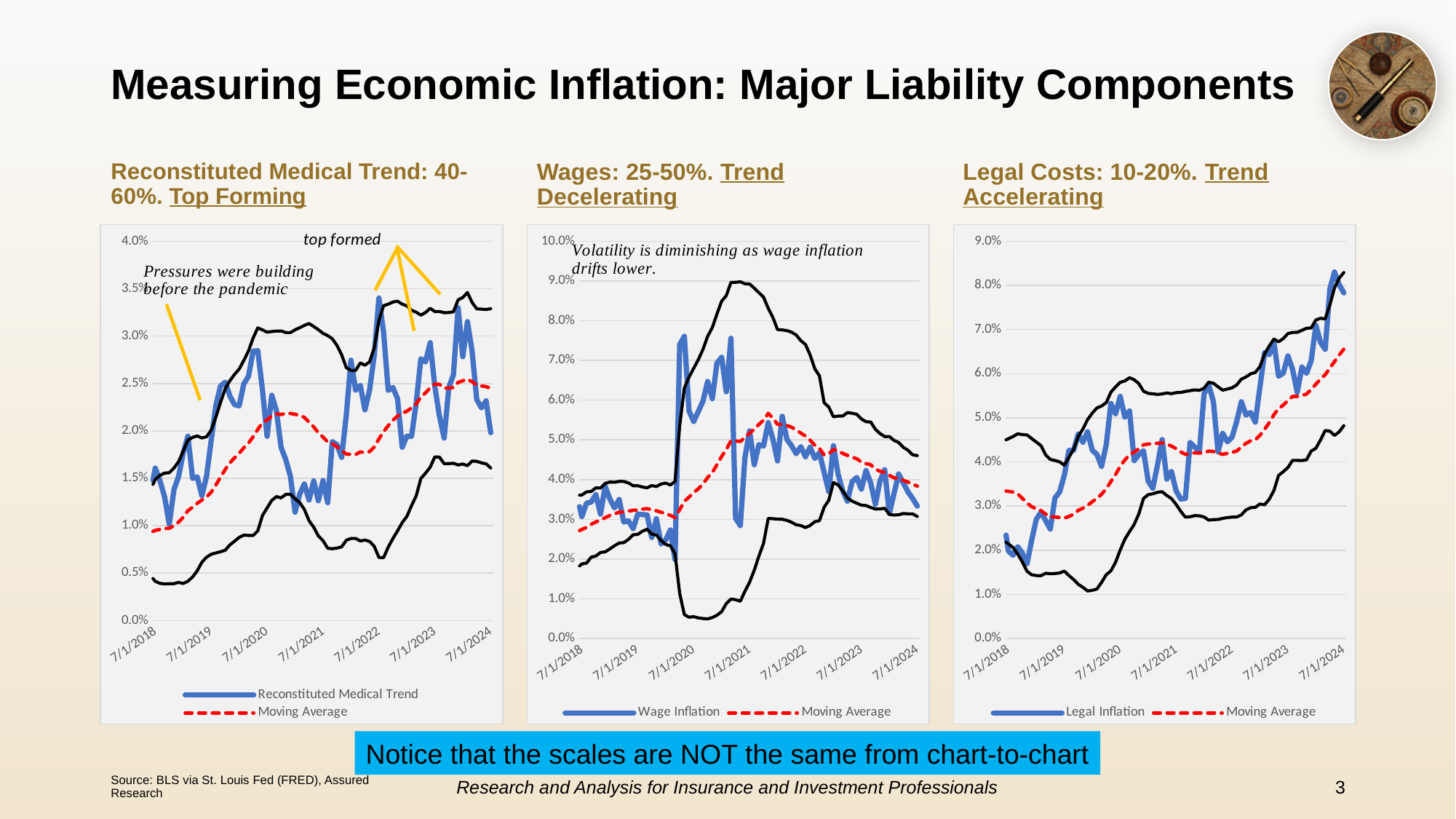
In the right chart, does Legal Inflation generally rise or fall from 7/1/2018 to 7/1/2024? Rise In the left chart, is the peak of the Reconstituted Medical Trend near 7/1/2022 greater or less than 3.0%? greater In the middle chart, is the peak value of Wage Inflation around 2020 greater or less than 7.0%? greater In the middle chart, does Wage Inflation rise or fall between 7/1/2022 and 7/1/2024? Fall In the right chart, is Legal Inflation higher at 7/1/2024 or at 7/1/2018? 7/1/2024 How many series does the legend of the middle chart (Wage Inflation) list? 2 How many dated tick labels are shown on the x axis of the left chart? 7 In the middle chart, is the Wage Inflation value at 7/1/2024 greater or less than 4.0%? less In the right chart (Legal Inflation), what are the two series named in the legend? Legal Inflation and Moving Average What type of chart is the left chart (Reconstituted Medical Trend)? Line chart